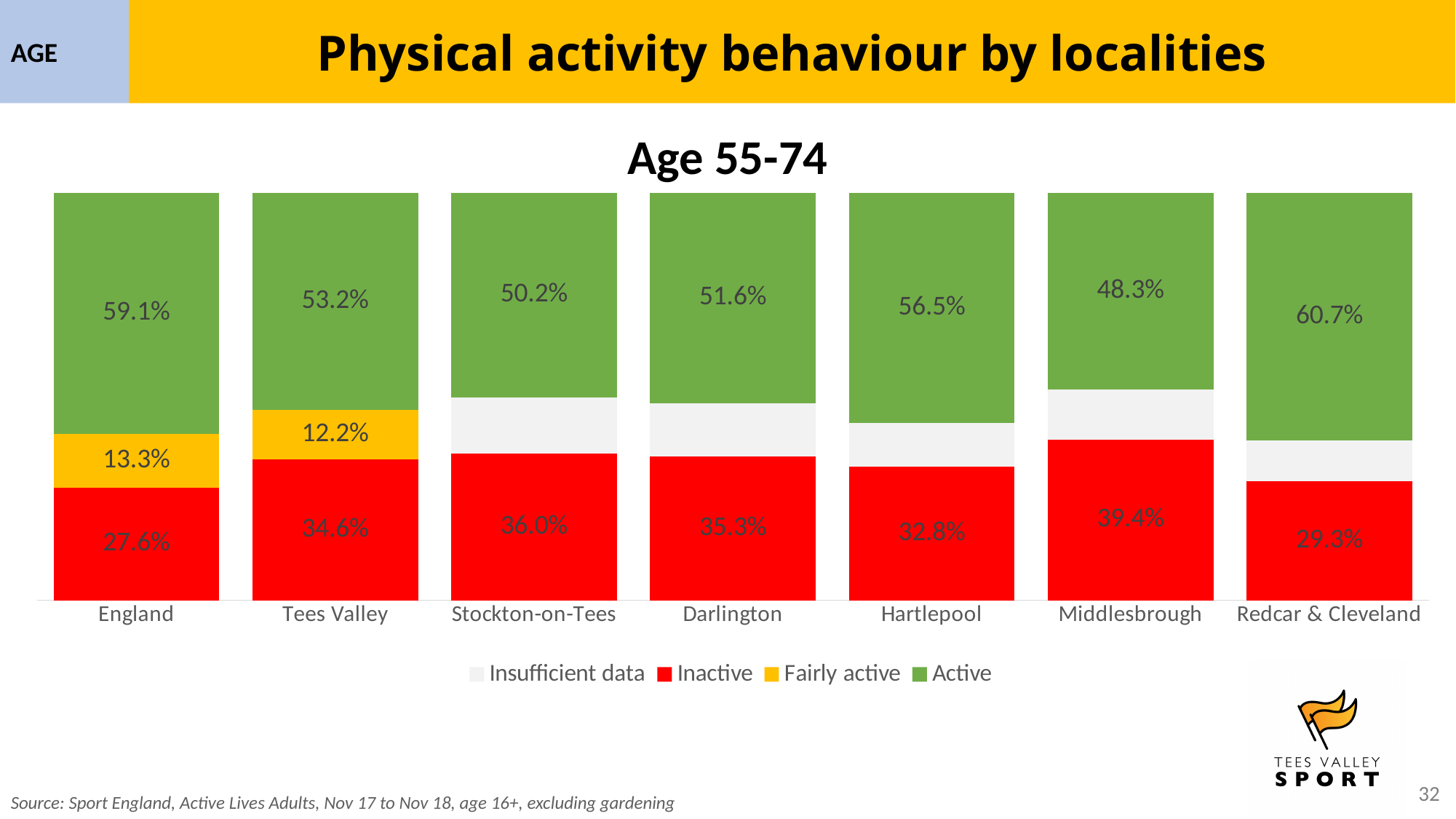
What is the Active percentage for Redcar & Cleveland? 60.7% Which locality has the lowest Active percentage? Middlesbrough What is the title of the chart? Age 55-74 Which has a higher Inactive percentage, Hartlepool or Stockton-on-Tees? Stockton-on-Tees Which locality has the highest Active percentage? Redcar & Cleveland How many localities are shown on the x axis? 7 How many series does the legend list? 4 What is the Fairly active percentage for Tees Valley? 12.2% What kind of chart is shown? Stacked bar chart What is the Inactive percentage for Middlesbrough? 39.4% What is the difference between the Active percentages for England and Tees Valley? 5.9% Which locality has the highest Inactive percentage? Middlesbrough